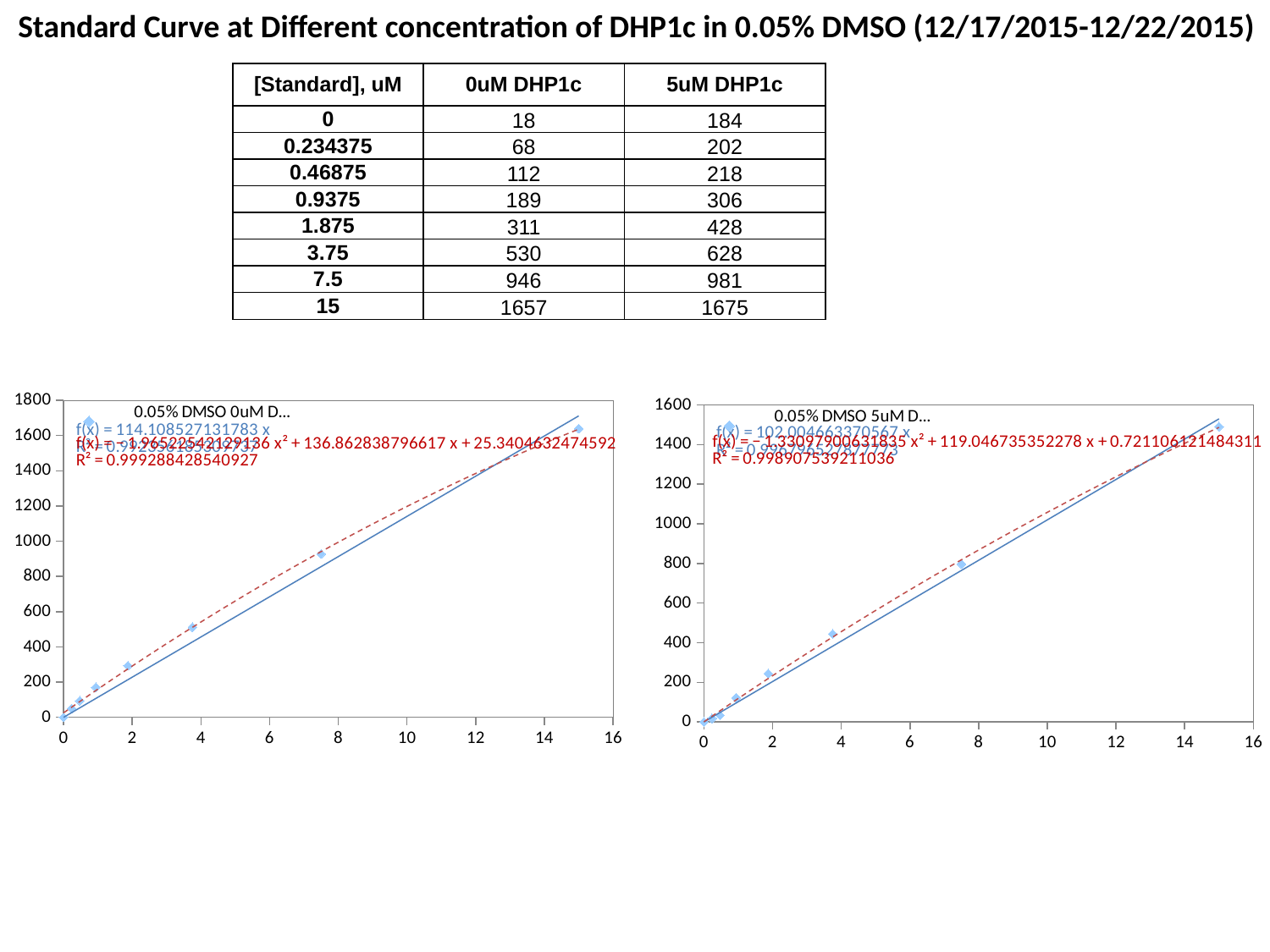
What kind of chart is the left chart (0.05% DMSO 0uM D...)? scatter chart On the right chart (0.05% DMSO 5uM D...), is the value at x = 15 greater or less than 1400? greater What is the highest value shown on the y axis of the left chart (0.05% DMSO 0uM D...)? 1800 On the right chart (0.05% DMSO 5uM D...), is the value at x = 3.75 greater or less than 400? greater On the right chart (0.05% DMSO 5uM D...), is the value at x = 7.5 greater or less than 1000? less How many data points are plotted on the right chart (0.05% DMSO 5uM D...)? 8 On the left chart (0.05% DMSO 0uM D...), do the plotted values rise or fall as x increases? rise On the right chart (0.05% DMSO 5uM D...), is the value at x = 15 larger or smaller than the value at x = 7.5? larger On the left chart (0.05% DMSO 0uM D...), at which x value is the highest plotted point? 15 What is the highest value shown on the y axis of the right chart (0.05% DMSO 5uM D...)? 1600